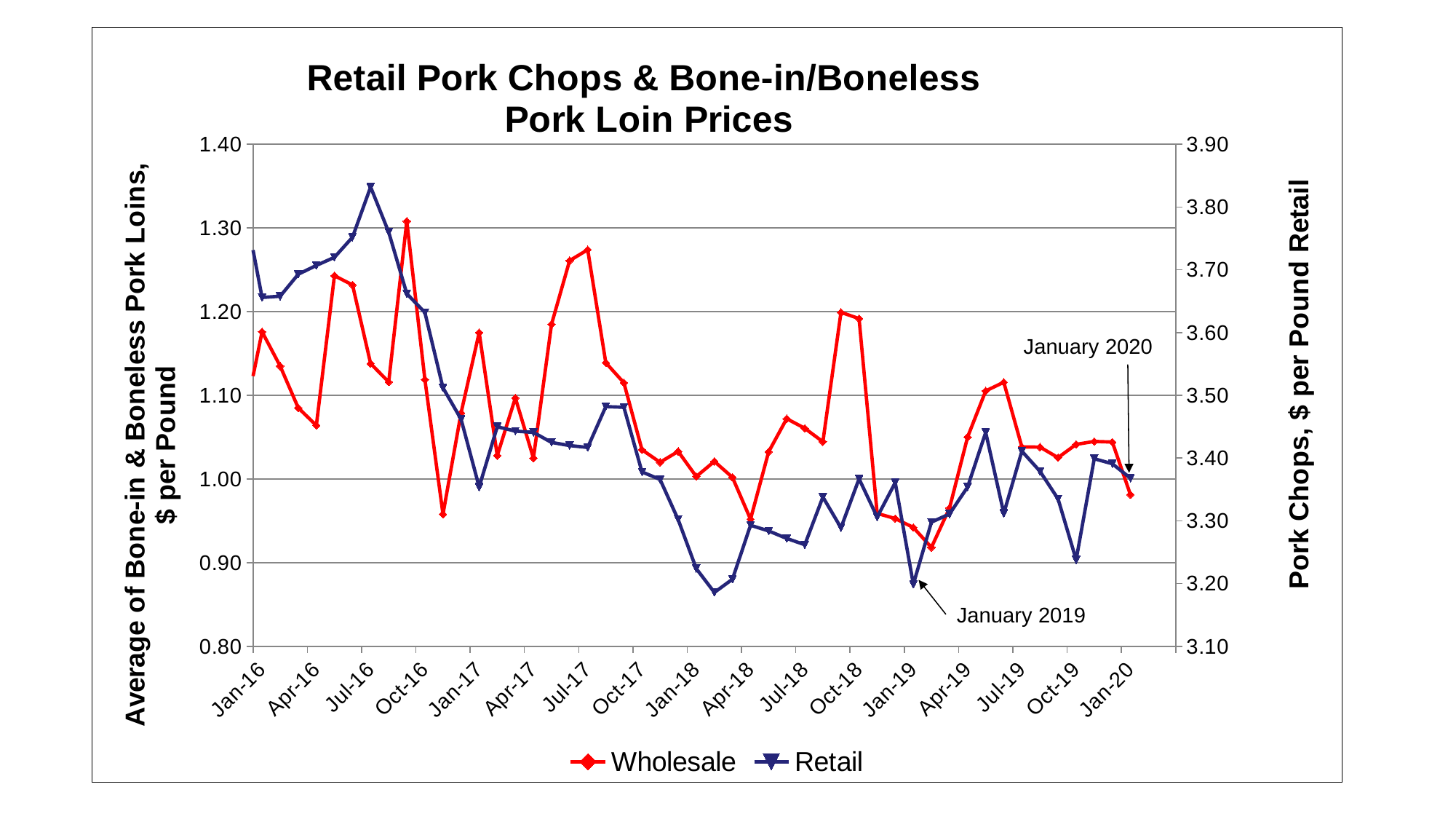
Which series is plotted in red? Wholesale Does the Retail series overall rise or fall from Jan-16 to Jan-20? fall What kind of chart is shown on the slide? Line chart How many month labels are shown along the x axis? 17 What is the title of the chart? Retail Pork Chops & Bone-in/Boneless Pork Loin Prices Is the Wholesale value at Jul-17 greater or less than 1.20? greater Among the labeled months on the x axis, at which does the Wholesale series reach its highest value? Jul-17 How many series does the legend list? 2 Is the Wholesale value at Jan-20 greater or less than 1.00? less Is the Retail value at Jan-20 greater or less than 3.40? less